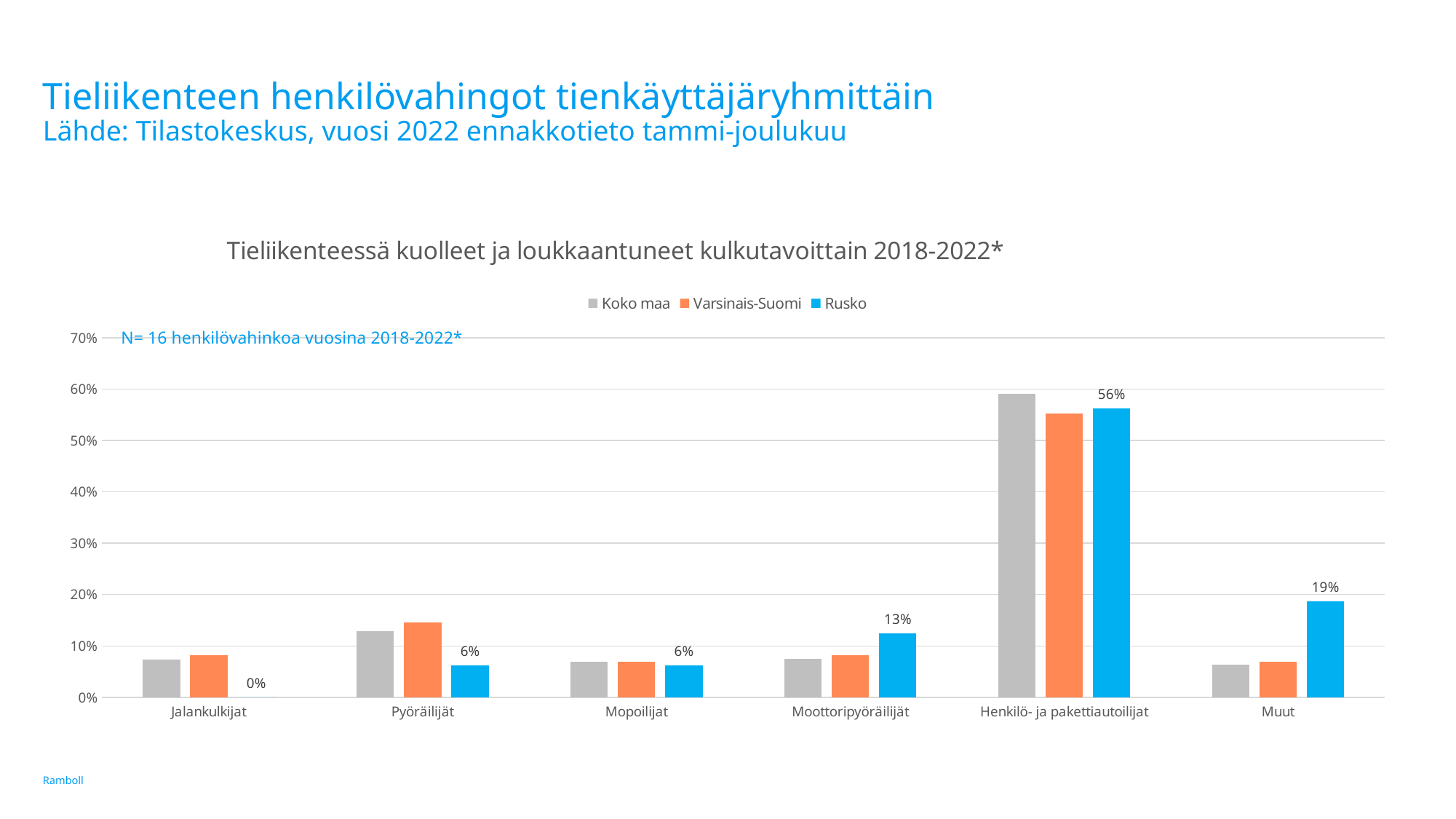
What kind of chart is shown on the slide? bar chart What is the value for Rusko in the Jalankulkijat category? 0% What is the value for Rusko in the Henkilö- ja pakettiautoilijat category? 56% Which category has the lowest value for Rusko? Jalankulkijat What is the value for Rusko in the Muut category? 19% How many series does the legend list? 3 Is the Varsinais-Suomi value for Pyöräilijät greater or less than 10%? greater What is the difference between the Rusko values for Muut and Moottoripyöräilijät? 6 percentage points Is the Koko maa value for Henkilö- ja pakettiautoilijat greater or less than 50%? greater In the Muut category, which is larger: the Koko maa value or the Rusko value? Rusko How many categories are shown on the x axis? 6 Which category has the highest value for Rusko? Henkilö- ja pakettiautoilijat